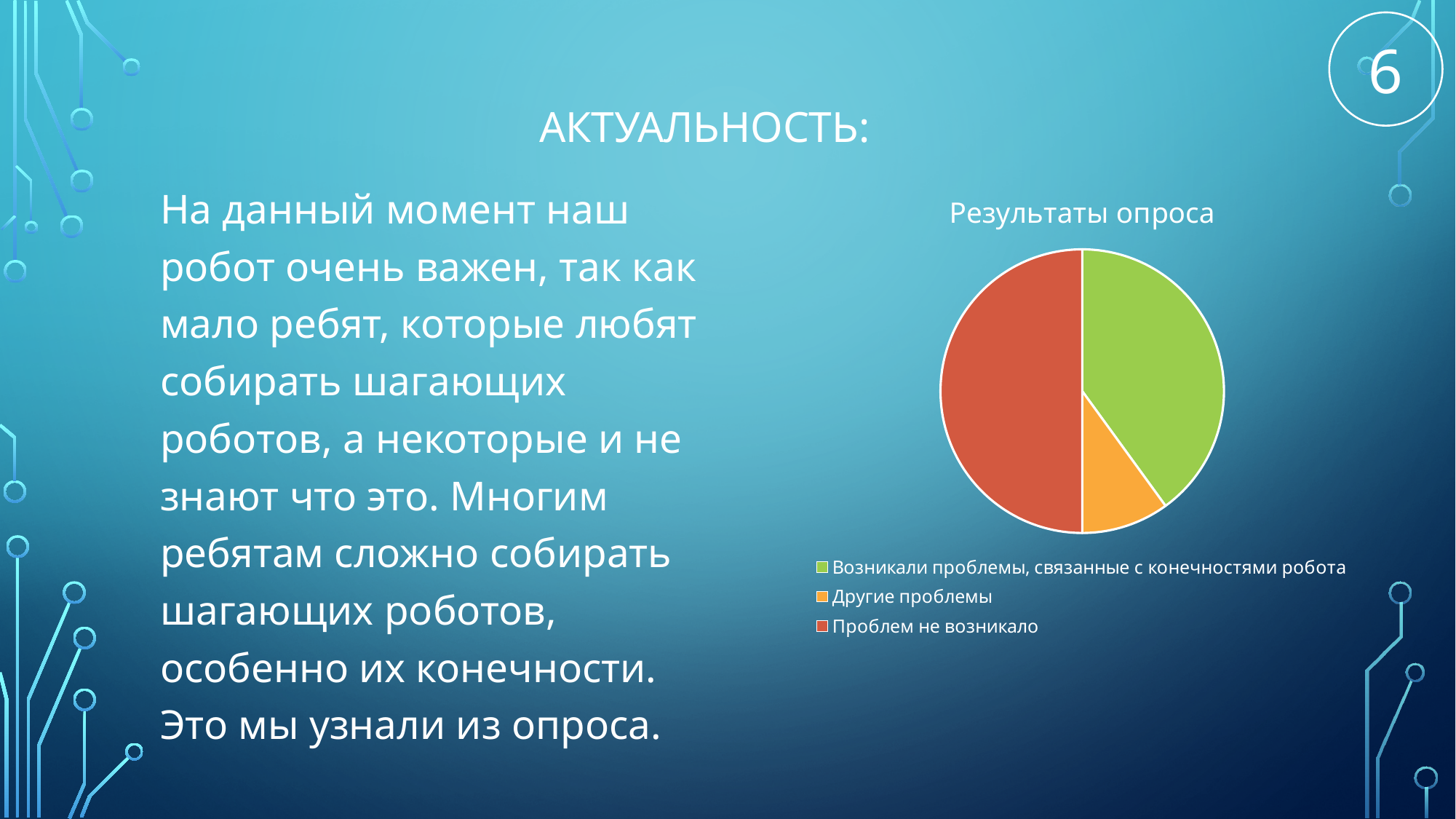
What colour is the slice for "Другие проблемы"? orange Which category has the smallest slice of the pie? Другие проблемы How many entries does the chart legend list? 3 Which category has the largest slice of the pie? Проблем не возникало Which slice is larger: "Проблем не возникало" or "Возникали проблемы, связанные с конечностями робота"? Проблем не возникало Which slice is larger: "Возникали проблемы, связанные с конечностями робота" or "Другие проблемы"? Возникали проблемы, связанные с конечностями робота How many slices does the pie chart have? 3 What kind of chart is shown on the slide? pie chart What is the title of the chart? Результаты опроса